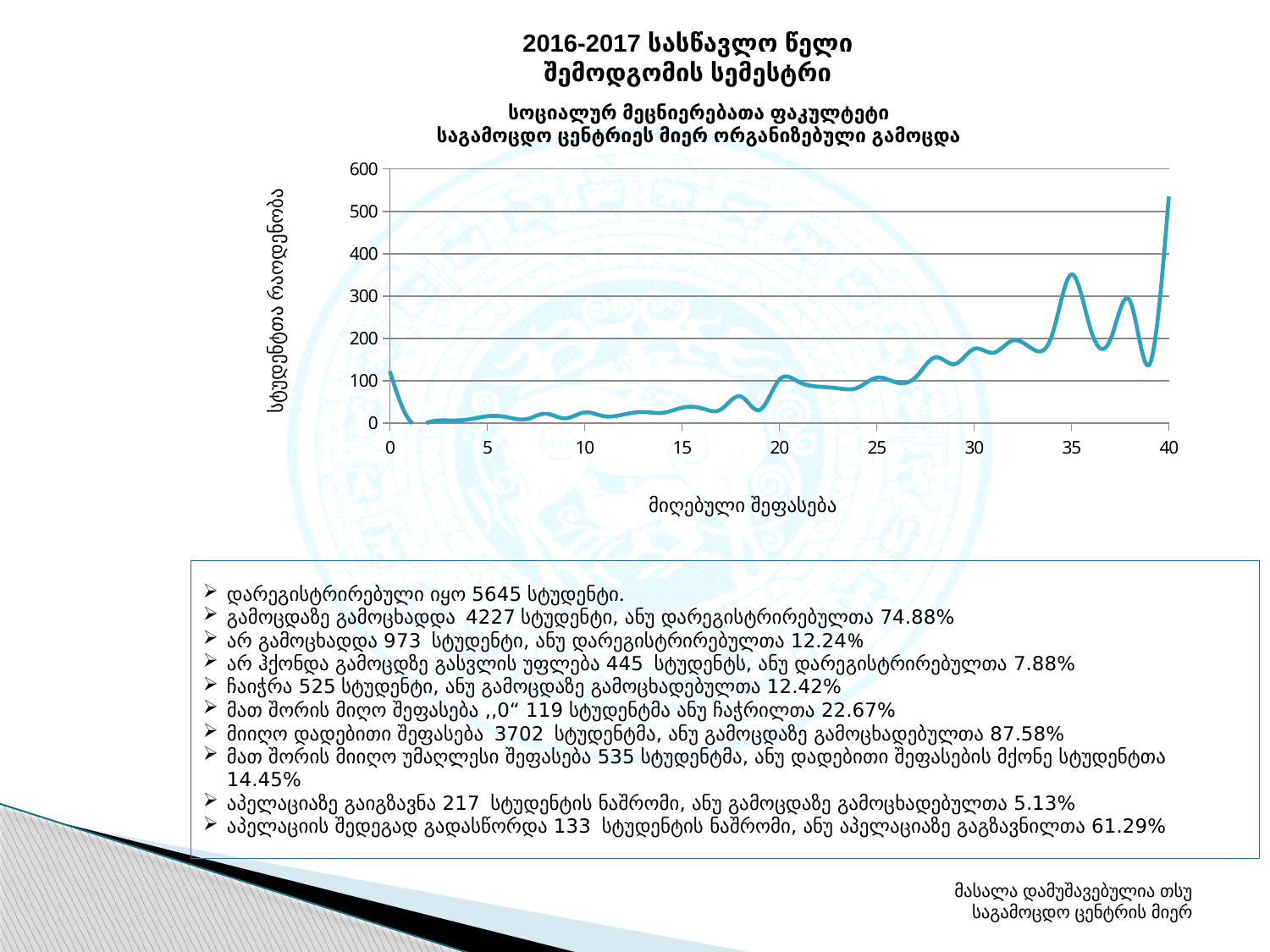
Is the value at a score of 10 greater or less than 100? less Which has the larger value, a score of 40 or a score of 35? 40 Is the value at a score of 40 greater or less than 500? greater At which score on the x axis does the line reach its highest value? 40 Is the value at a score of 35 greater or less than 300? greater What kind of chart is shown on the slide? line chart Which has the larger value, a score of 35 or a score of 30? 35 Does the line generally rise or fall as the score increases from 5 to 40? rise What is the highest value shown on the y axis? 600